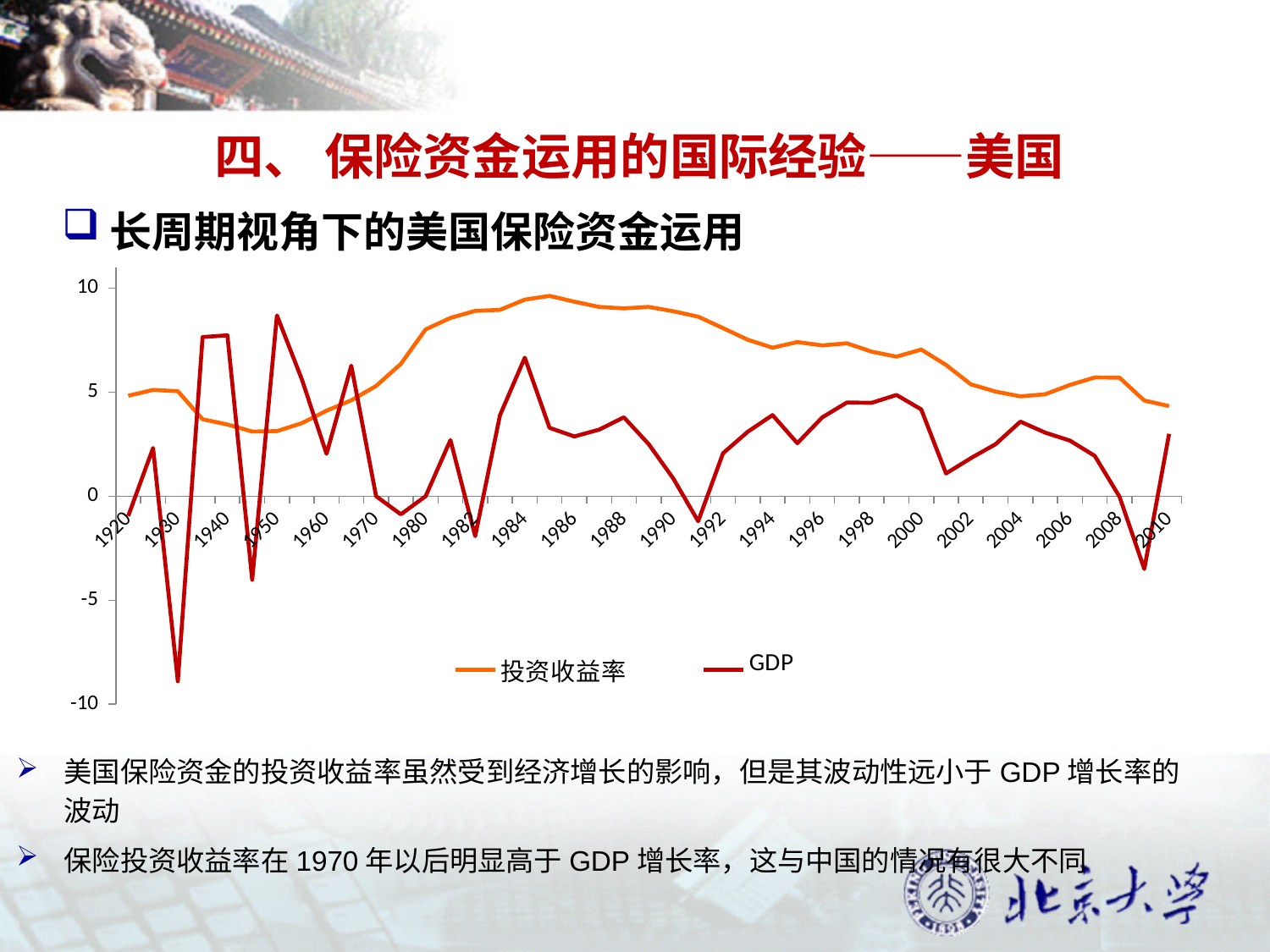
What are the two series named in the legend? 投资收益率 and GDP In 1986, which series has the higher value, 投资收益率 or GDP? 投资收益率 Is the lowest value of GDP in the 1930s greater or less than -5? less In 1940, which series has the higher value, 投资收益率 or GDP? GDP Is the value of GDP in 2009 greater or less than 0? less Is the value of 投资收益率 in 1950 greater or less than 5? less Does 投资收益率 generally rise or fall from 1986 to 2010? fall What kind of chart is shown on the slide? line chart Which series reaches the lowest value on the chart? GDP How many series does the legend list? 2 Which series is drawn in orange? 投资收益率